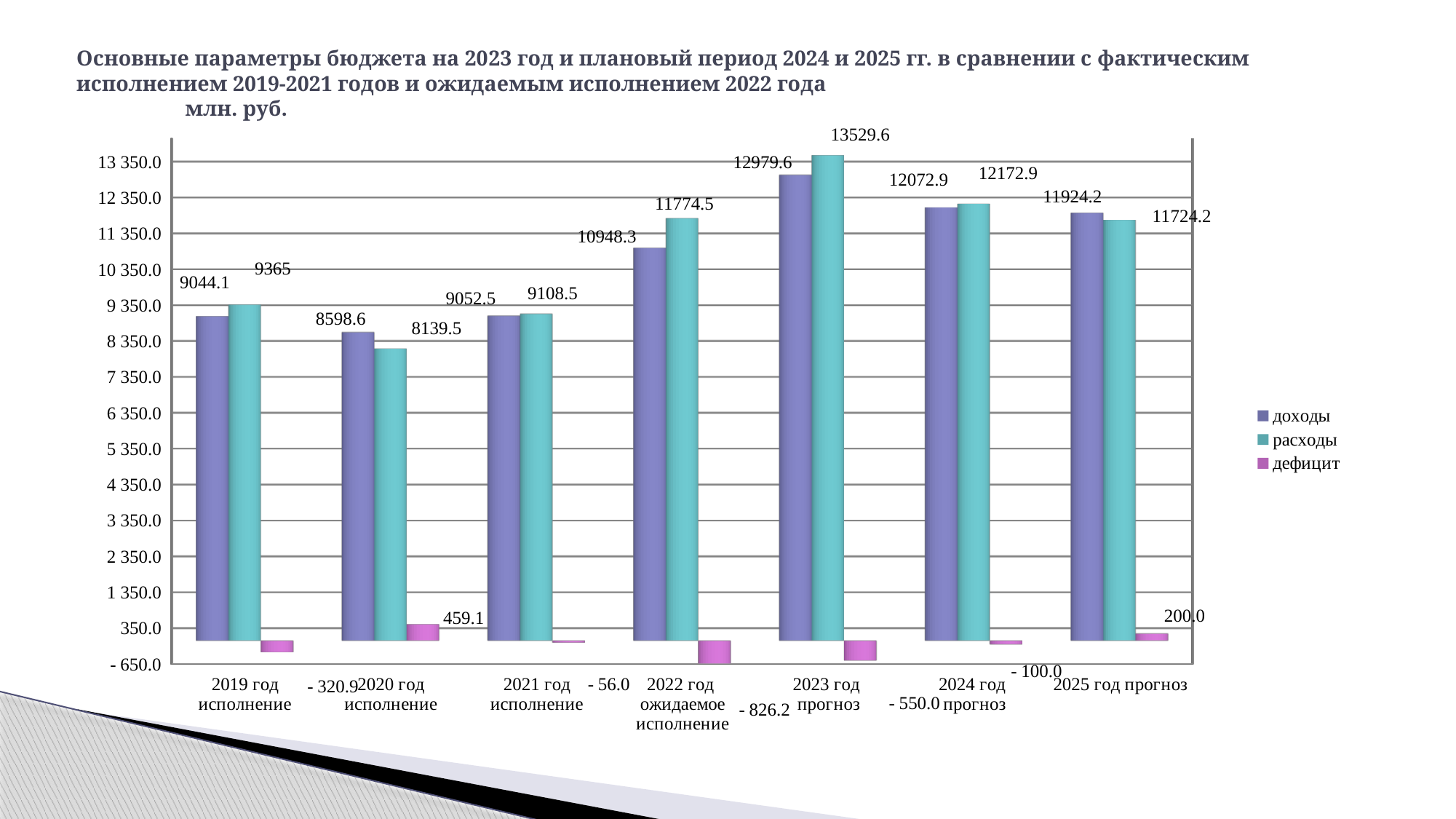
What is the value of доходы for 2023 год прогноз? 12979.6 What kind of chart is shown on the slide? bar chart What unit of measurement is indicated above the chart? млн. руб. Which category has the lowest value for доходы? 2020 год исполнение How many categories (years) are shown on the x axis? 7 In 2025 год прогноз, which is larger: доходы or расходы? доходы What is the value of дефицит for 2022 год ожидаемое исполнение? - 826.2 Do the values for доходы rise or fall from 2023 год прогноз to 2025 год прогноз? fall How many series does the legend list? 3 What is the value of расходы for 2020 год исполнение? 8139.5 Which category has the highest value for расходы? 2023 год прогноз By how much do расходы exceed доходы in 2023 год прогноз? 550.0